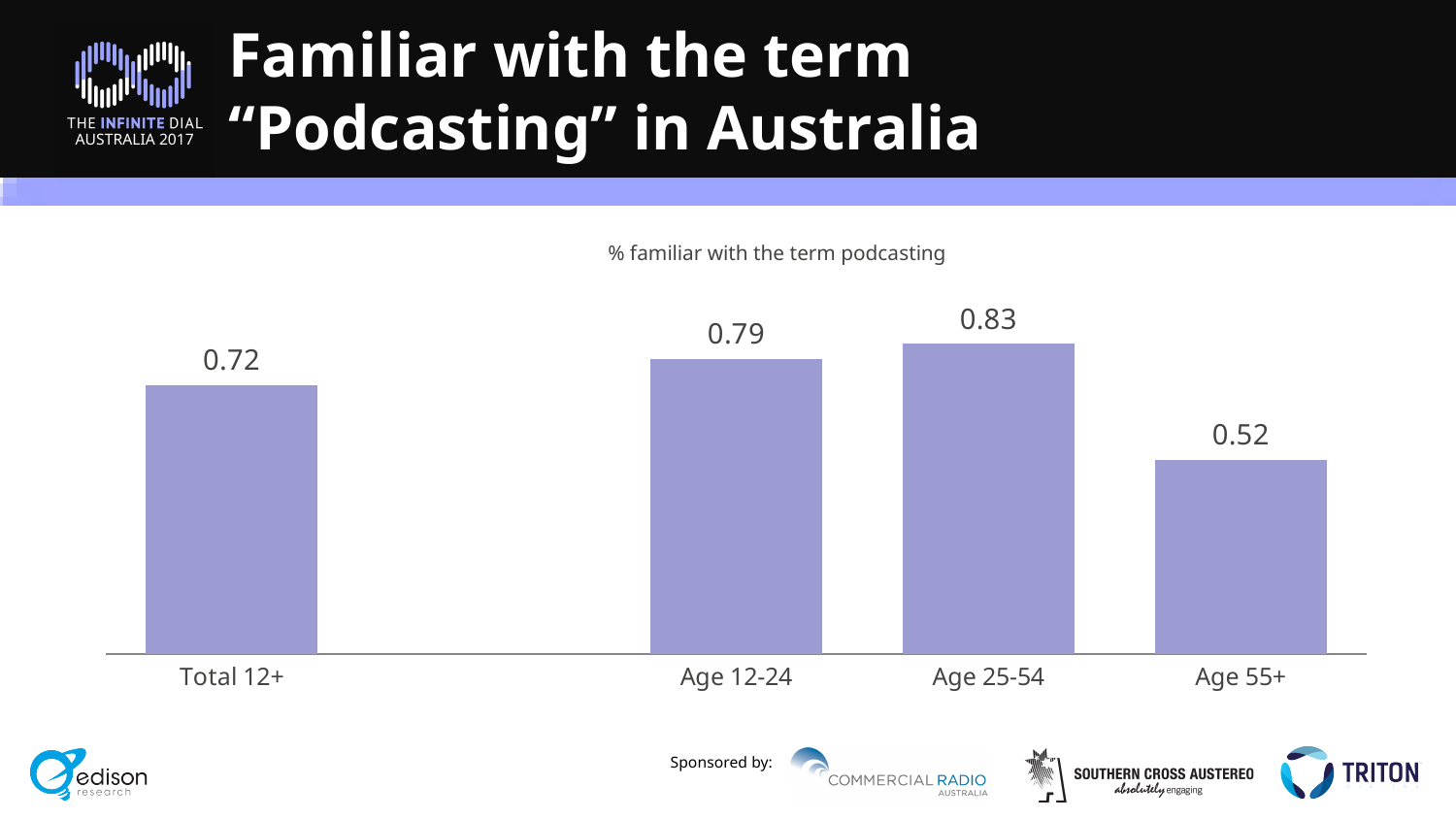
How many categories are shown on the chart? 4 What is the title of the chart? % familiar with the term podcasting Which category has the lowest value? Age 55+ What is the value for Age 55+? 0.52 What is the difference between the values for Age 25-54 and Age 55+? 0.31 What is the value for Total 12+? 0.72 What is the value for Age 12-24? 0.79 What kind of chart is shown on the slide? Bar chart Which category has the highest value? Age 25-54 What is the difference between the values for Age 12-24 and Total 12+? 0.07 Which is larger, the value for Age 12-24 or the value for Age 55+? Age 12-24 What is the value for Age 25-54? 0.83